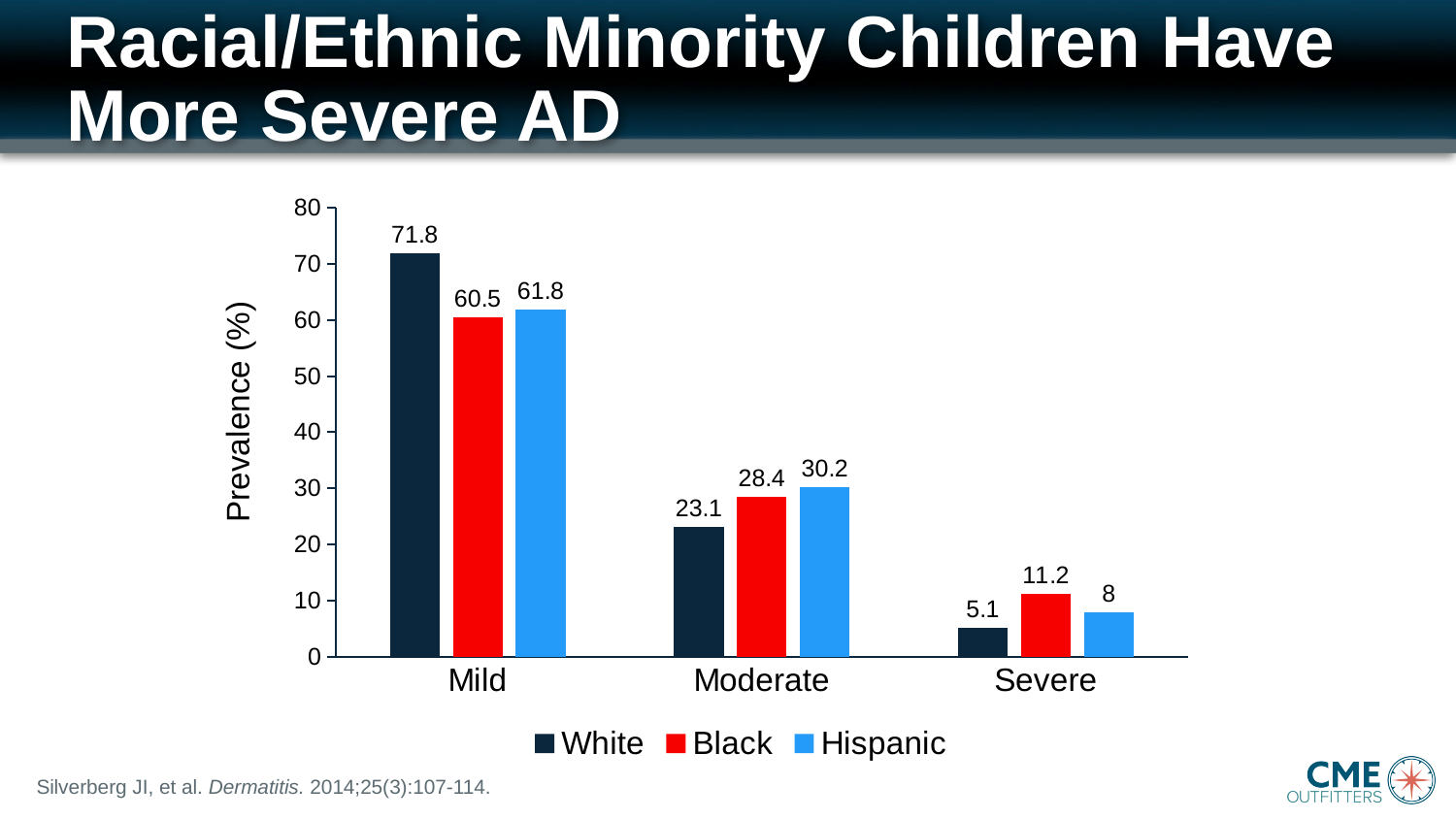
How many series does the legend list? 3 Which is larger: the Hispanic value for Moderate or the Black value for Moderate? Hispanic What is the prevalence (%) for White children with Mild AD? 71.8 What kind of chart is shown on the slide? Bar chart How many severity categories are shown on the x axis? 3 Which group has the lowest prevalence in the Moderate category? White What is the prevalence (%) for Black children with Moderate AD? 28.4 What is the label of the y axis? Prevalence (%) Do the White prevalence values rise or fall from Mild to Severe? Fall What is the prevalence (%) for Hispanic children with Severe AD? 8 What is the difference between the White and Black prevalence values in the Mild category? 11.3 Which group has the highest prevalence in the Severe category? Black